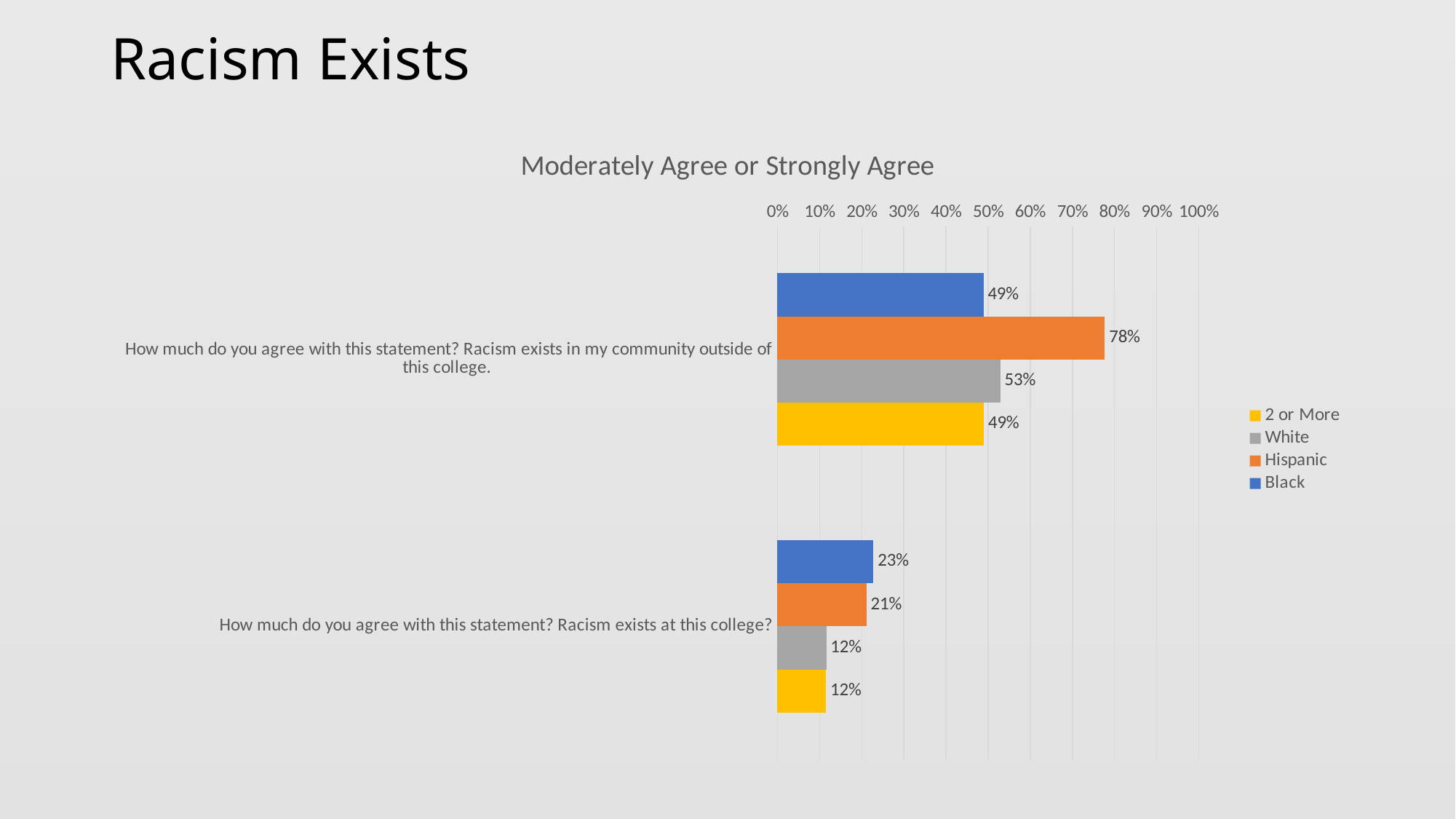
What is the title of the chart? Moderately Agree or Strongly Agree What kind of chart is shown on the slide? Bar chart For the statement that racism exists at this college, which is larger: the Black percentage or the Hispanic percentage? Black What percentage of Hispanic respondents moderately or strongly agree that racism exists in their community outside of this college? 78% Which group has the highest share agreeing that racism exists at this college? Black How many statements (categories) are shown on the chart? 2 What percentage of Black respondents moderately or strongly agree that racism exists at this college? 23% How many series does the legend list? 4 Is the Hispanic value for racism existing in the community outside of this college greater or less than 70%? greater What is the difference between the Hispanic and White percentages for the statement that racism exists in the community outside of this college? 25% Which group has the highest share agreeing that racism exists in their community outside of this college? Hispanic What percentage of White respondents moderately or strongly agree that racism exists at this college? 12%